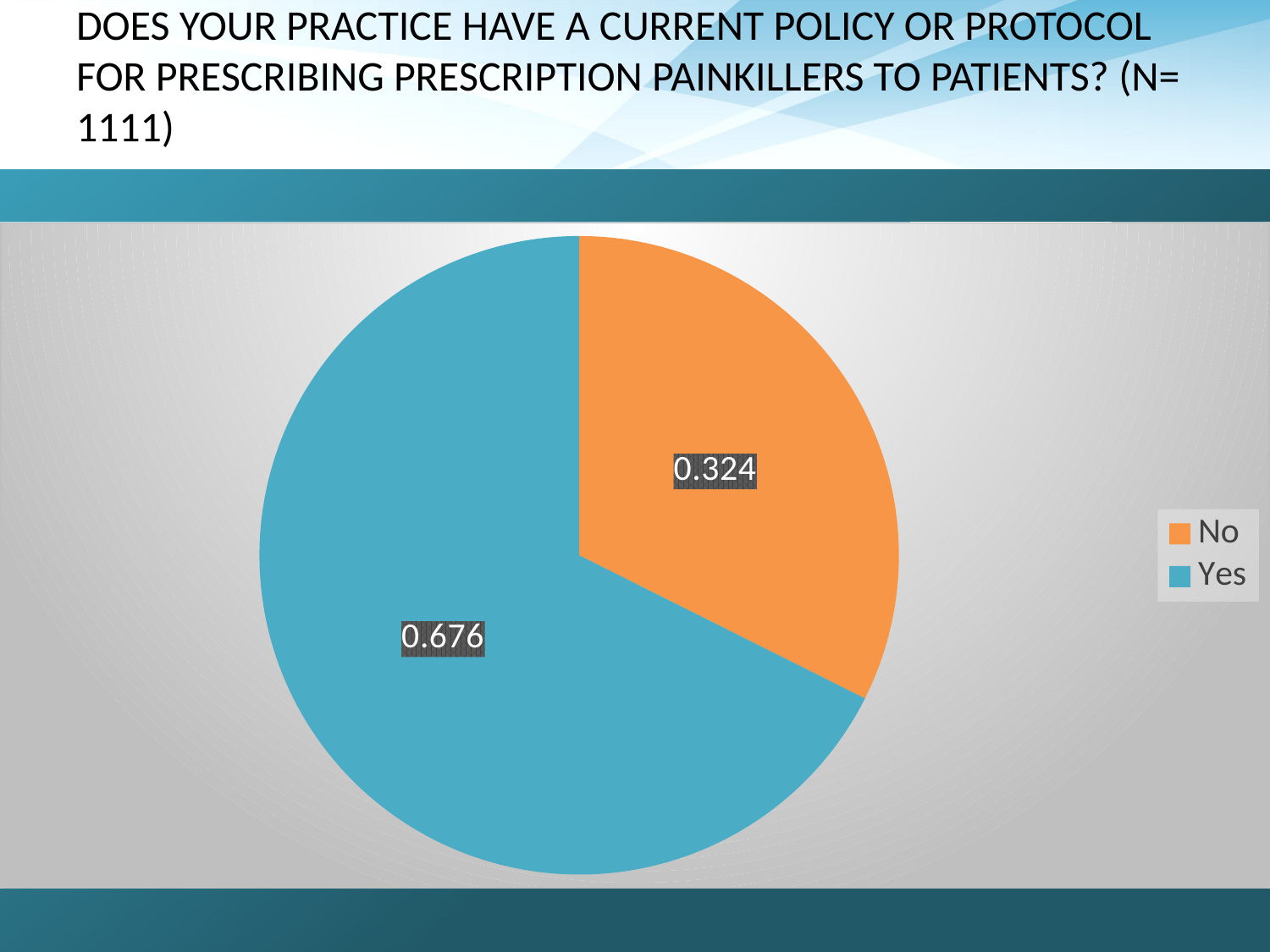
Which is larger, the "Yes" slice or the "No" slice? Yes What is the difference between the "Yes" value and the "No" value? 0.352 What is the total of the two values shown on the pie chart? 1.000 What is the value shown for the "No" slice? 0.324 What sample size (N) is given in the chart title? 1111 What kind of chart is shown on the slide? Pie chart Which category has the smallest slice of the pie? No What is the value shown for the "Yes" slice? 0.676 How many categories does the pie chart show? 2 Which category has the largest slice of the pie? Yes What colour is the "No" slice in the pie chart? Orange